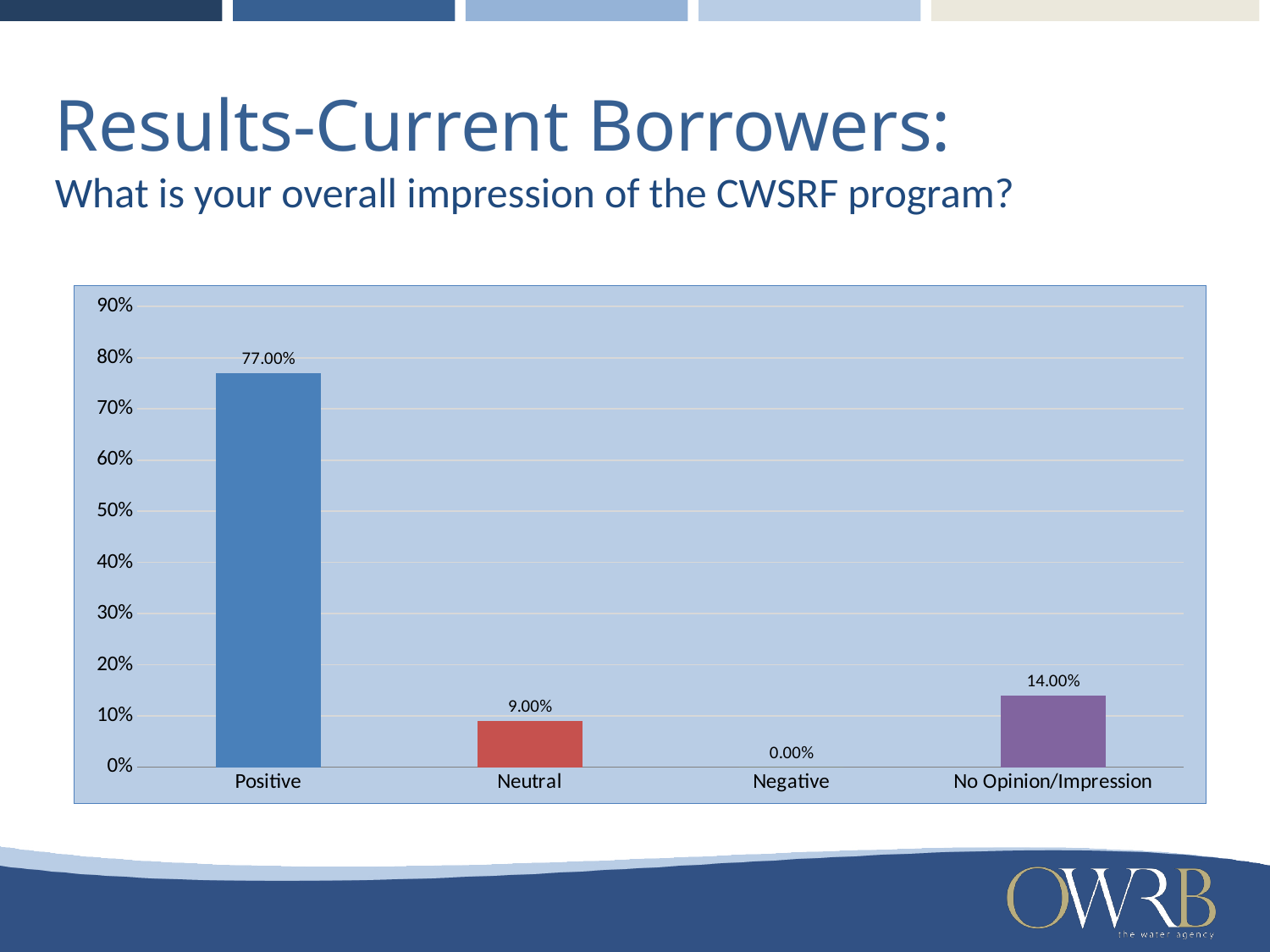
Which category has the highest value? Positive Which is larger, the value for Neutral or the value for No Opinion/Impression? No Opinion/Impression What kind of chart is shown on the slide? bar chart Is the value for Positive greater or less than 70%? greater What is the difference between the values for Positive and No Opinion/Impression? 63.00% How many categories are shown on the x axis? 4 Which category has the lowest value? Negative What question does the chart on the slide present results for? What is your overall impression of the CWSRF program? What is the value for Negative? 0.00% What is the value for No Opinion/Impression? 14.00% What is the value for Positive? 77.00% What is the value for Neutral? 9.00%